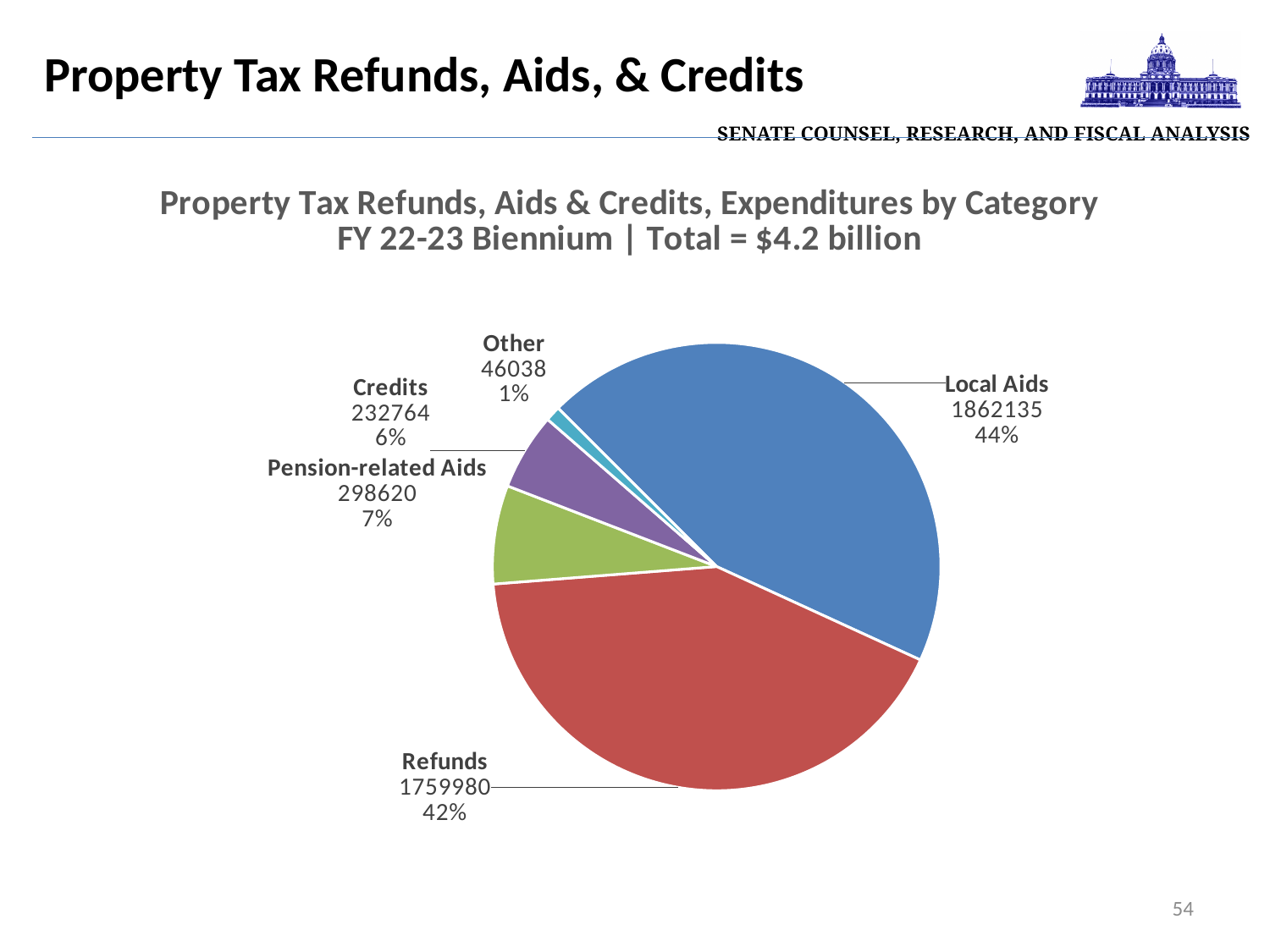
What total is stated in the chart title? $4.2 billion What is the value for Local Aids? 1862135 What is the difference between the values for Local Aids and Refunds? 102155 How many categories are shown in the pie chart? 5 Which category has the smallest share of the pie? Other What percentage share of the pie does Refunds represent? 42% What type of chart is shown on the slide? pie chart What is the value for Refunds? 1759980 Which category has the largest share of the pie? Local Aids What is the value for Pension-related Aids? 298620 What is the value for Other? 46038 What is the value for Credits? 232764